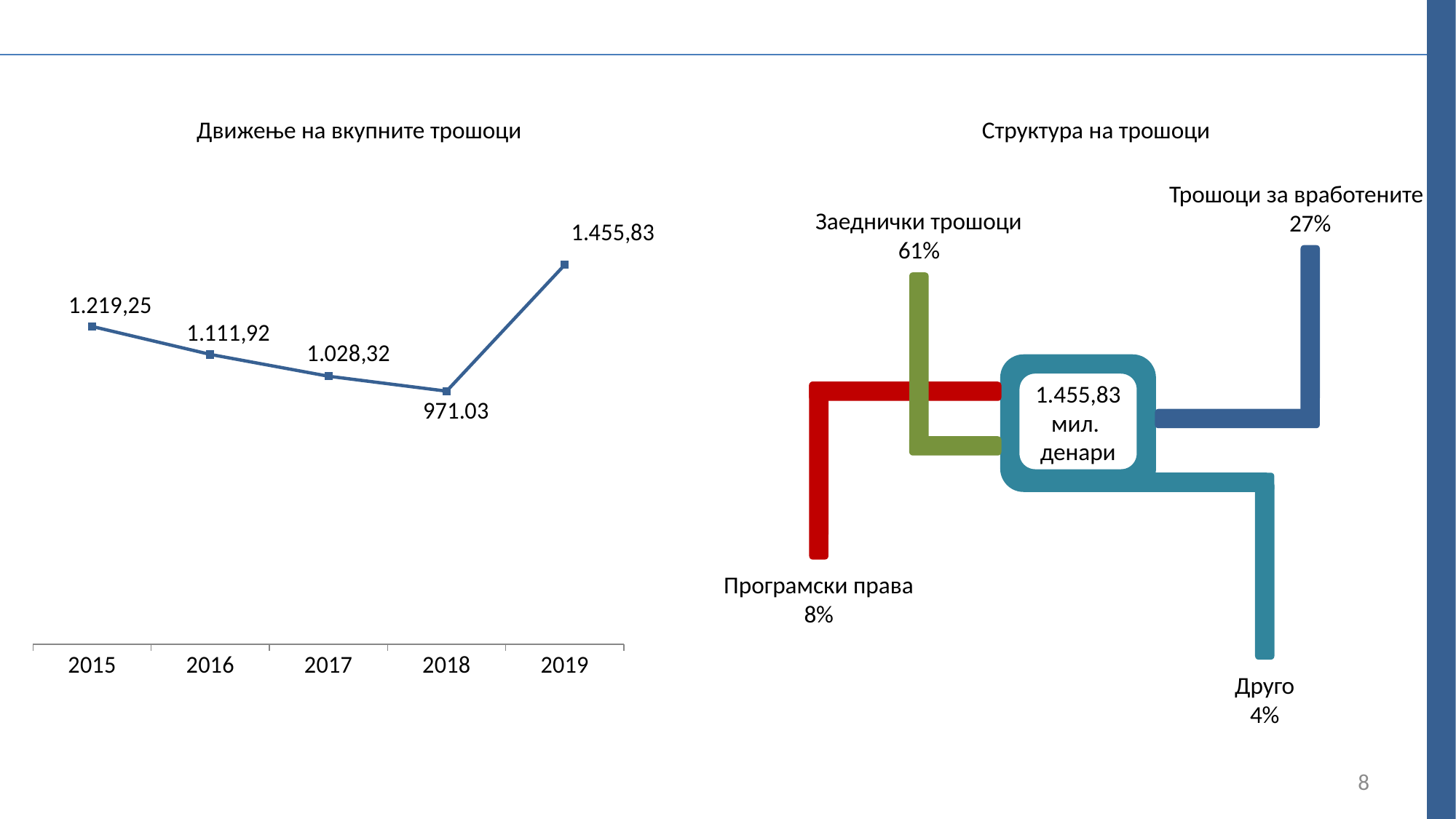
In the chart titled 'Движење на вкупните трошоци', what is the value for 2015? 1.219,25 In the chart titled 'Движење на вкупните трошоци', what is the value for 2019? 1.455,83 In the chart titled 'Движење на вкупните трошоци', which year has the lowest value? 2018 In the chart titled 'Движење на вкупните трошоци', how many years are shown on the x axis? 5 What kind of chart is 'Движење на вкупните трошоци'? Line chart In the chart titled 'Движење на вкупните трошоци', what is the value for 2018? 971.03 In the chart titled 'Движење на вкупните трошоци', which is larger, the value for 2016 or the value for 2017? 2016 In the chart titled 'Движење на вкупните трошоци', which year has the highest value? 2019 In the diagram titled 'Структура на трошоци', which category has the smallest share? Друго In the chart titled 'Движење на вкупните трошоци', do the values rise or fall from 2015 to 2018? Fall In the chart titled 'Движење на вкупните трошоци', what is the difference between the values for 2015 and 2016? 107,33 In the diagram titled 'Структура на трошоци', what share is shown for 'Заеднички трошоци'? 61%